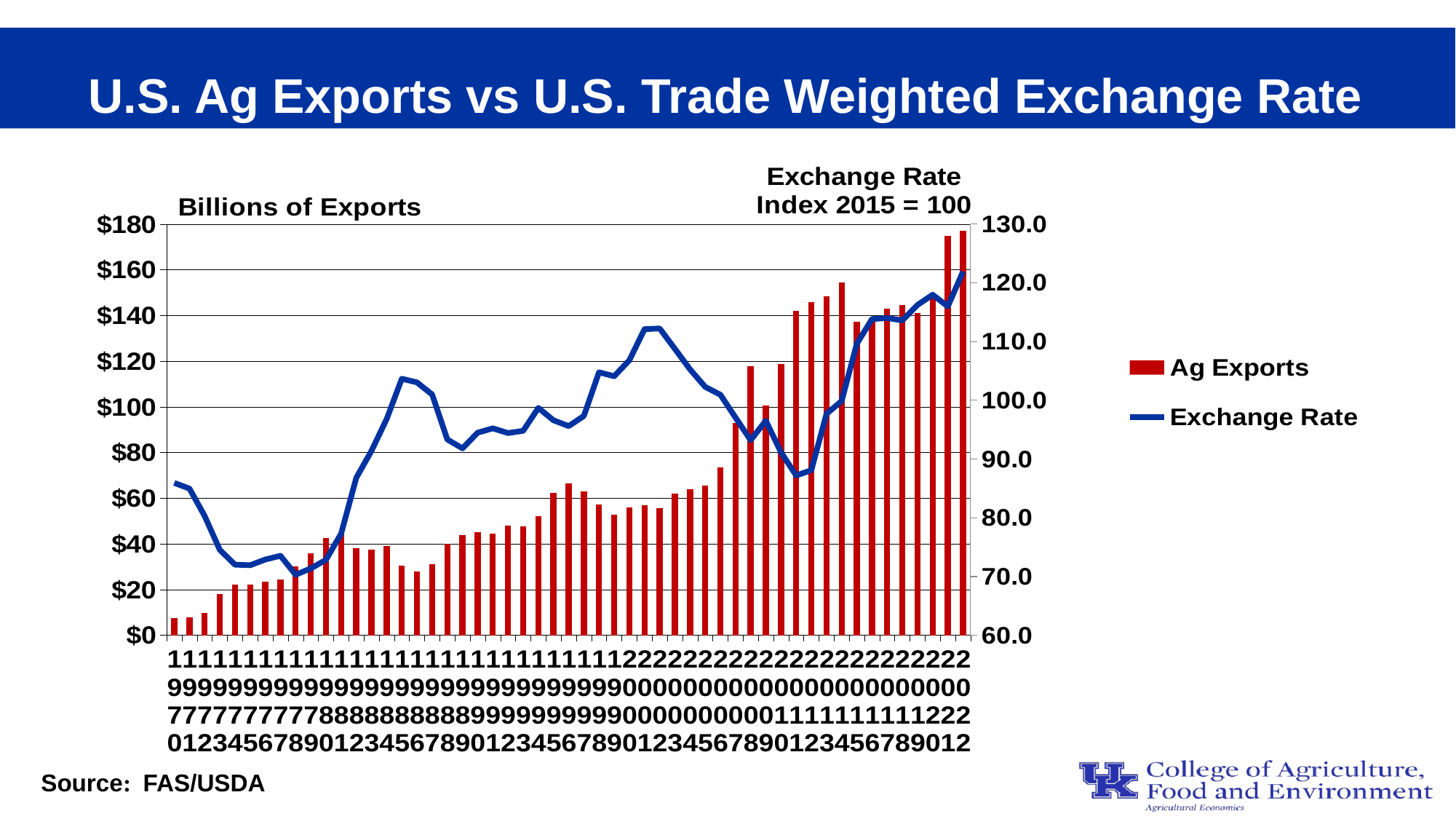
In which year are Ag Exports lowest? 1970 Which series is drawn as bars? Ag Exports What is the title of the chart? U.S. Ag Exports vs U.S. Trade Weighted Exchange Rate Is the Exchange Rate for 1978 greater or less than 80.0? less How many series does the legend list? 2 Which year has larger Ag Exports, 2020 or 2021? 2021 Is the value of Ag Exports for 2022 greater or less than $160? greater How many years are plotted along the x axis? 53 What kind of chart is shown on the slide? A combination bar and line chart Is the value of Ag Exports for 1970 greater or less than $20? less Do Ag Exports generally rise or fall from 1970 to 2022? rise In which year are Ag Exports highest? 2022